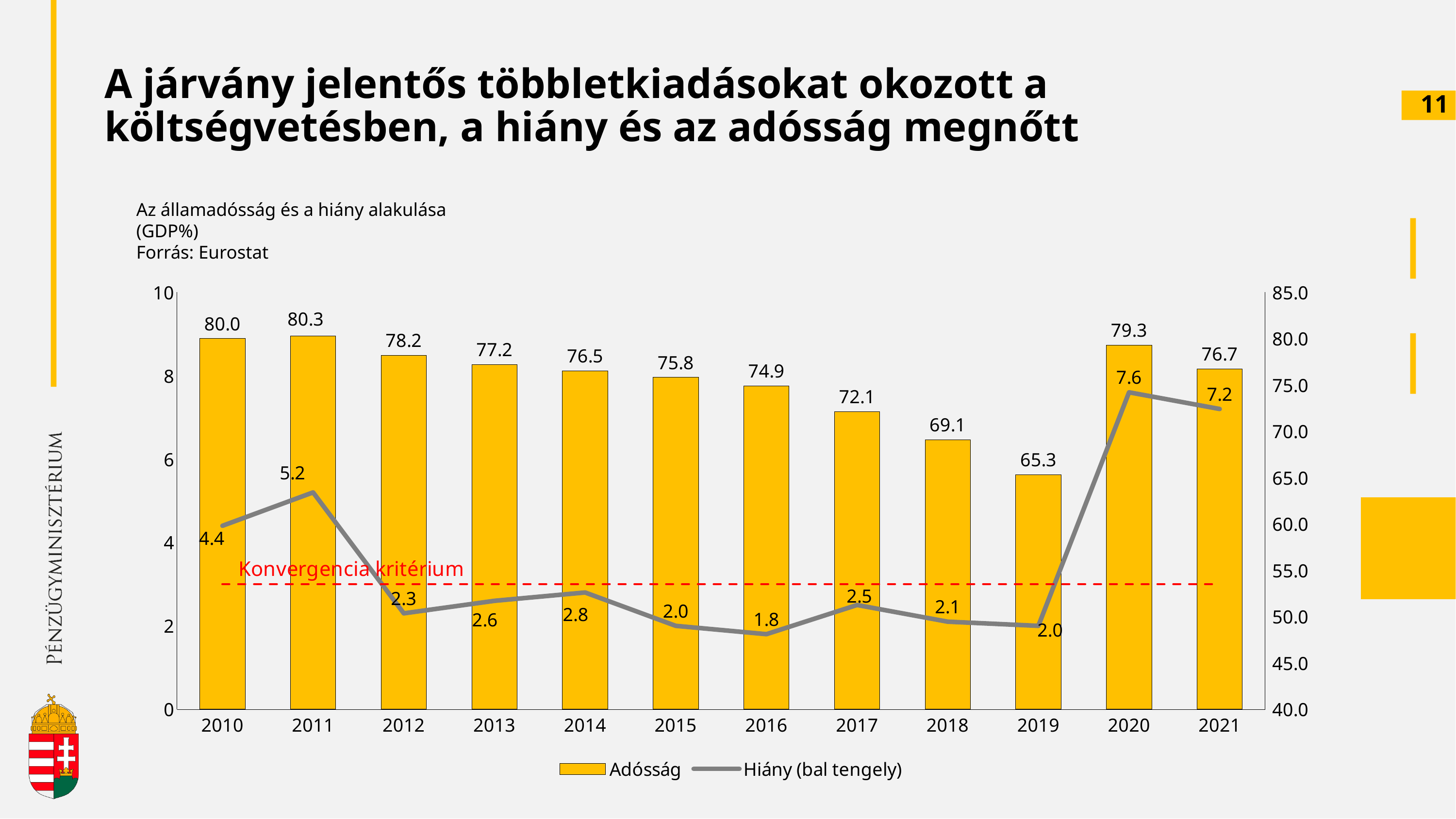
How many years are shown on the x axis? 12 Which is larger, the Hiány value for 2011 or for 2021? 2021 What kinds of chart are combined on this slide? Bar chart and line chart Does the Adósság value rise or fall from 2011 to 2019? Fall Which year has the highest Adósság value? 2011 What is the difference between the Adósság values for 2020 and 2019? 14.0 What is the source cited for the chart? Eurostat Which year has the lowest Hiány (bal tengely) value? 2016 What is the Hiány (bal tengely) value for 2020? 7.6 What is the Adósság value for 2019? 65.3 What is the Adósság value for 2021? 76.7 How many series does the legend list? 2